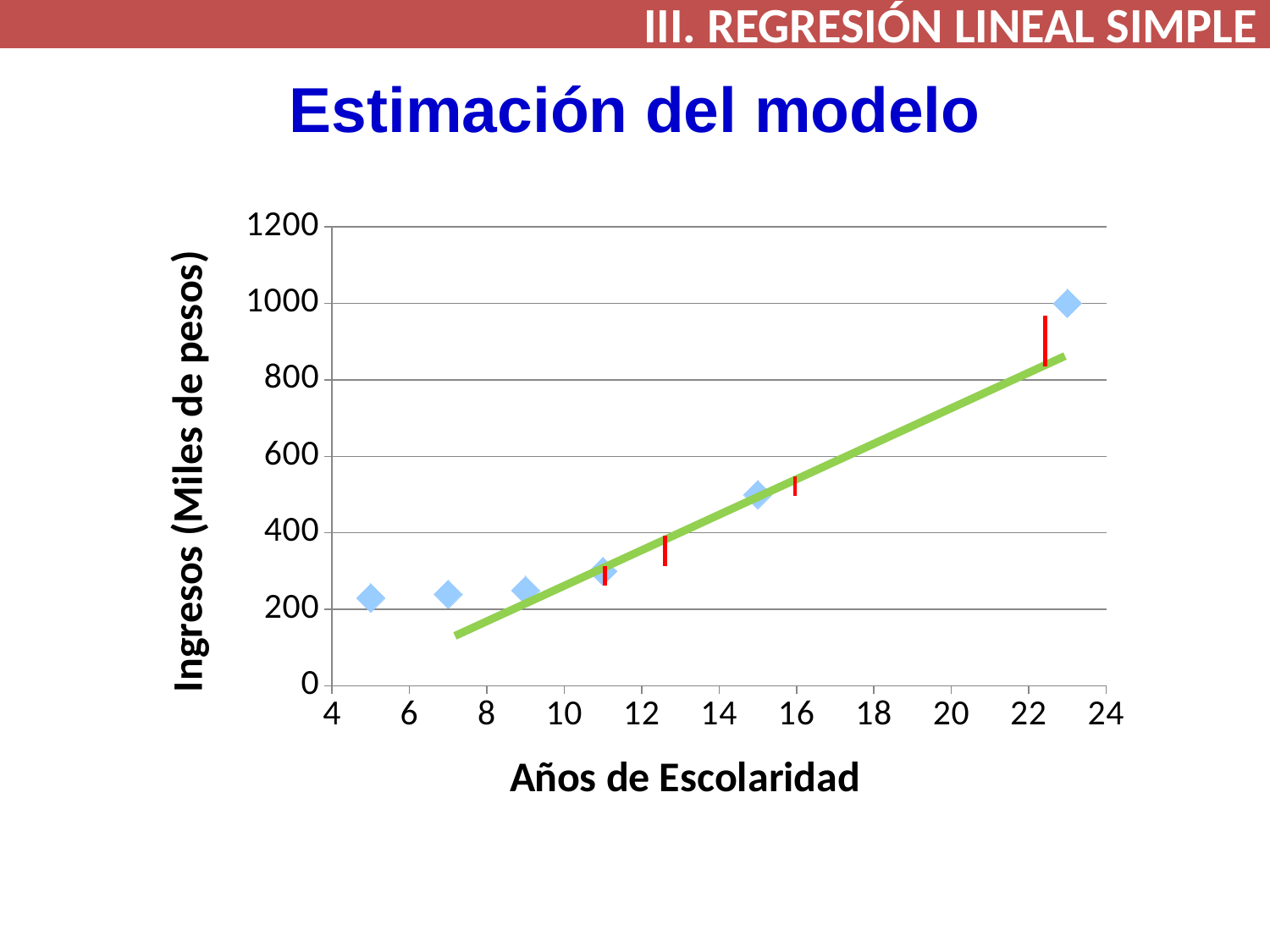
Is the income value for the point at 11 years of schooling greater or less than 200? greater Which point has a larger income value: the one at 15 years of schooling or the one at 9 years of schooling? 15 years of schooling How many data points are plotted in the chart? 6 Is the income value for the point at 5 years of schooling greater or less than 400? less Do the income values generally rise or fall as years of schooling increase? rise Is the income value for the point at 23 years of schooling greater or less than 800? greater What is the title of the chart's y axis? Ingresos (Miles de pesos) What is the title of the chart's x axis? Años de Escolaridad What is the maximum value shown on the y axis? 1200 What kind of chart is shown on the slide? scatter chart Which data point has the highest income value (Ingresos)? the point at 23 years of schooling